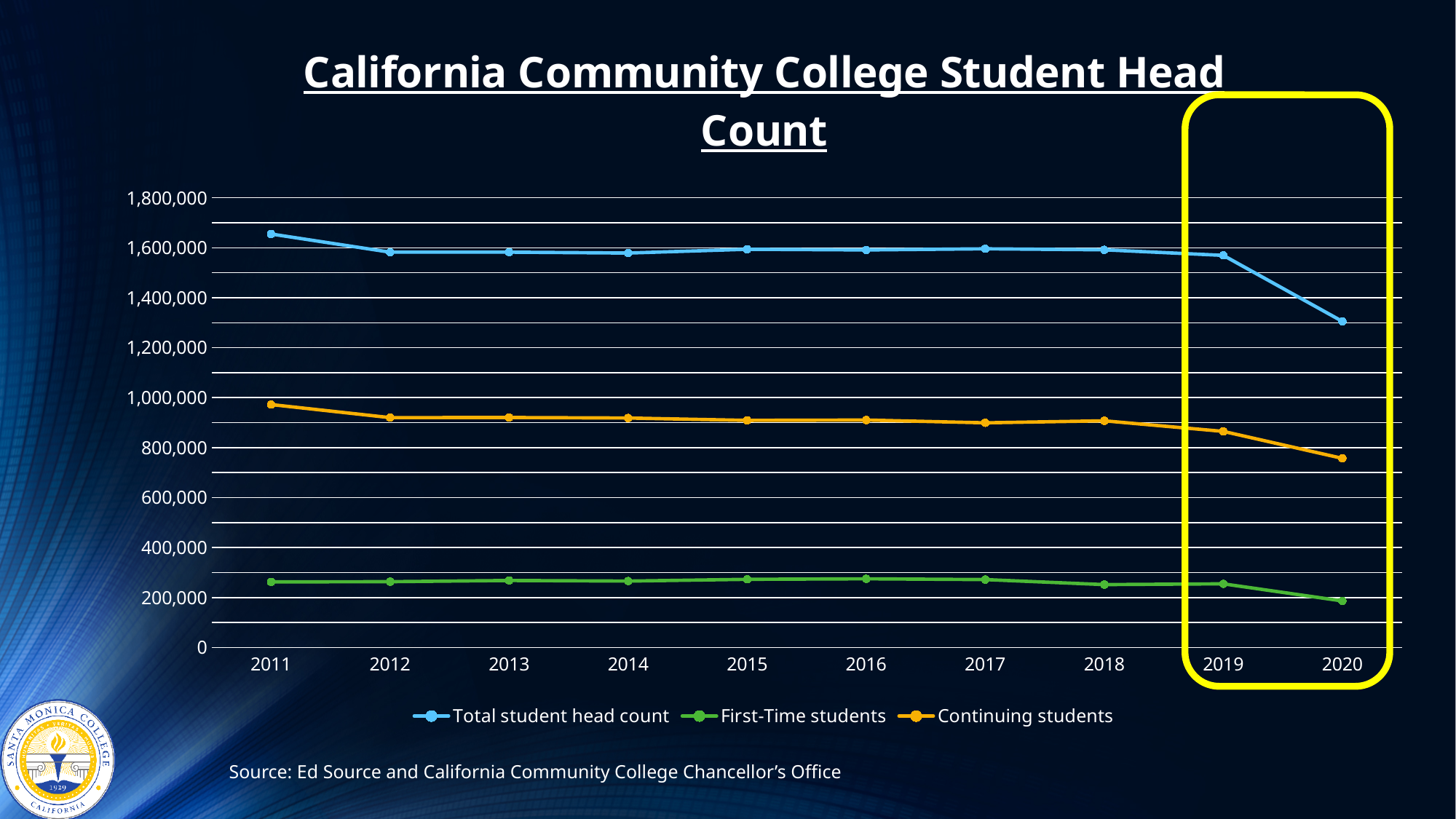
In 2015, which is larger: Continuing students or First-Time students? Continuing students In which year is the Total student head count lowest? 2020 Does the Total student head count rise or fall from 2019 to 2020? fall Is the value for Continuing students in 2011 greater or less than 800,000? greater In which year is the Continuing students value lowest? 2020 In which year is the Total student head count highest? 2011 How many series does the legend list? 3 Is the value for Total student head count in 2020 greater or less than 1,400,000? less How many years are plotted along the x axis? 10 Is the value for First-Time students in 2020 greater or less than 400,000? less What kind of chart is shown on the slide? line chart